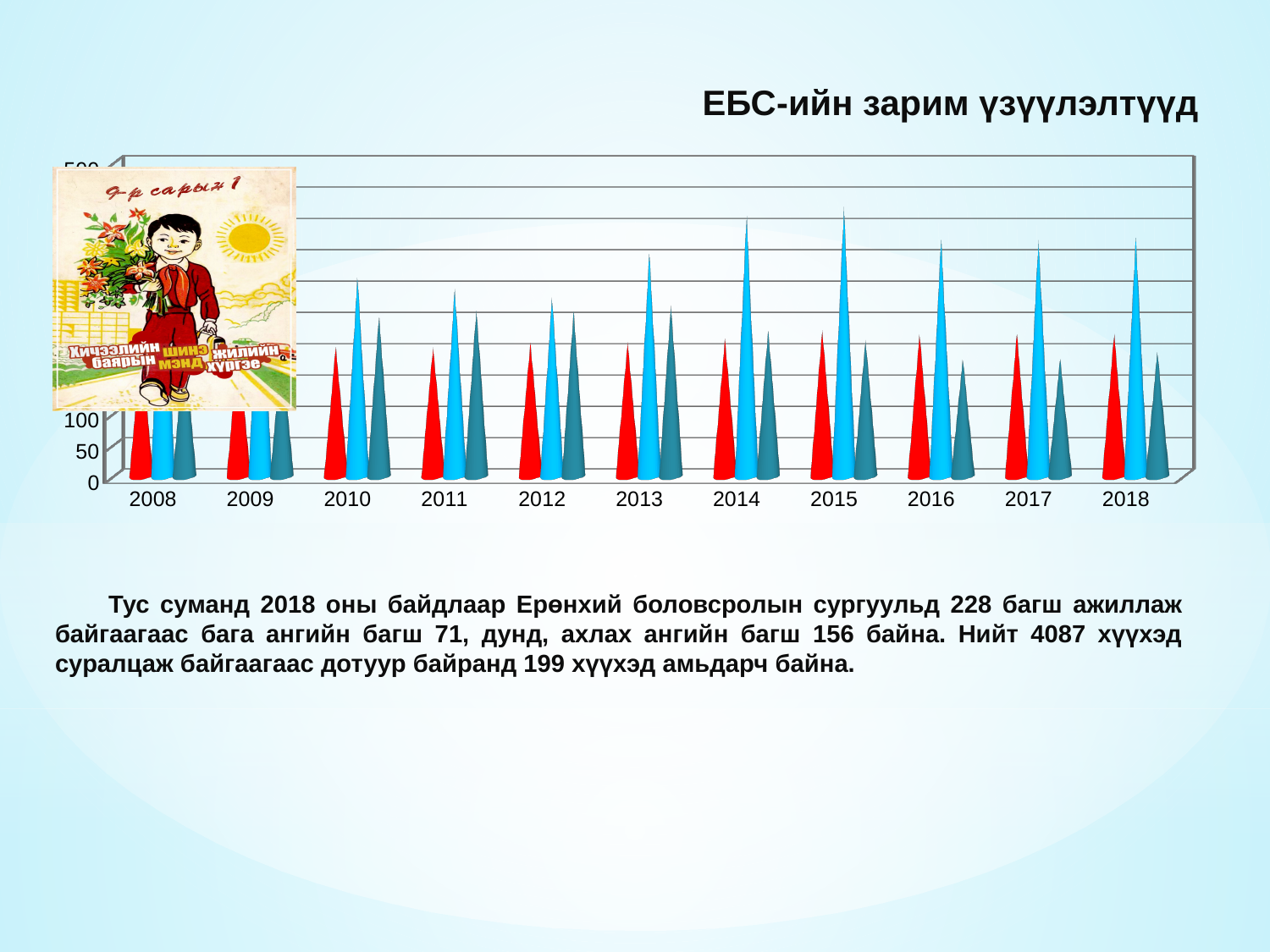
Is the value of the light blue bar for 2014 greater or less than 100? greater Is the value of the teal bar for 2016 greater or less than 100? greater Which is larger, the teal bar for 2014 or the teal bar for 2018? 2014 Is the value of the red bar for 2015 greater or less than 100? greater What is the first year shown on the x axis of the chart? 2008 Which is larger, the light blue bar for 2014 or the light blue bar for 2010? 2014 What is the title of the chart? ЕБС-ийн зарим үзүүлэлтүүд How many bars are plotted for each year in the chart? 3 What kind of chart is shown on the slide? Bar chart How many years are shown on the x axis of the chart? 11